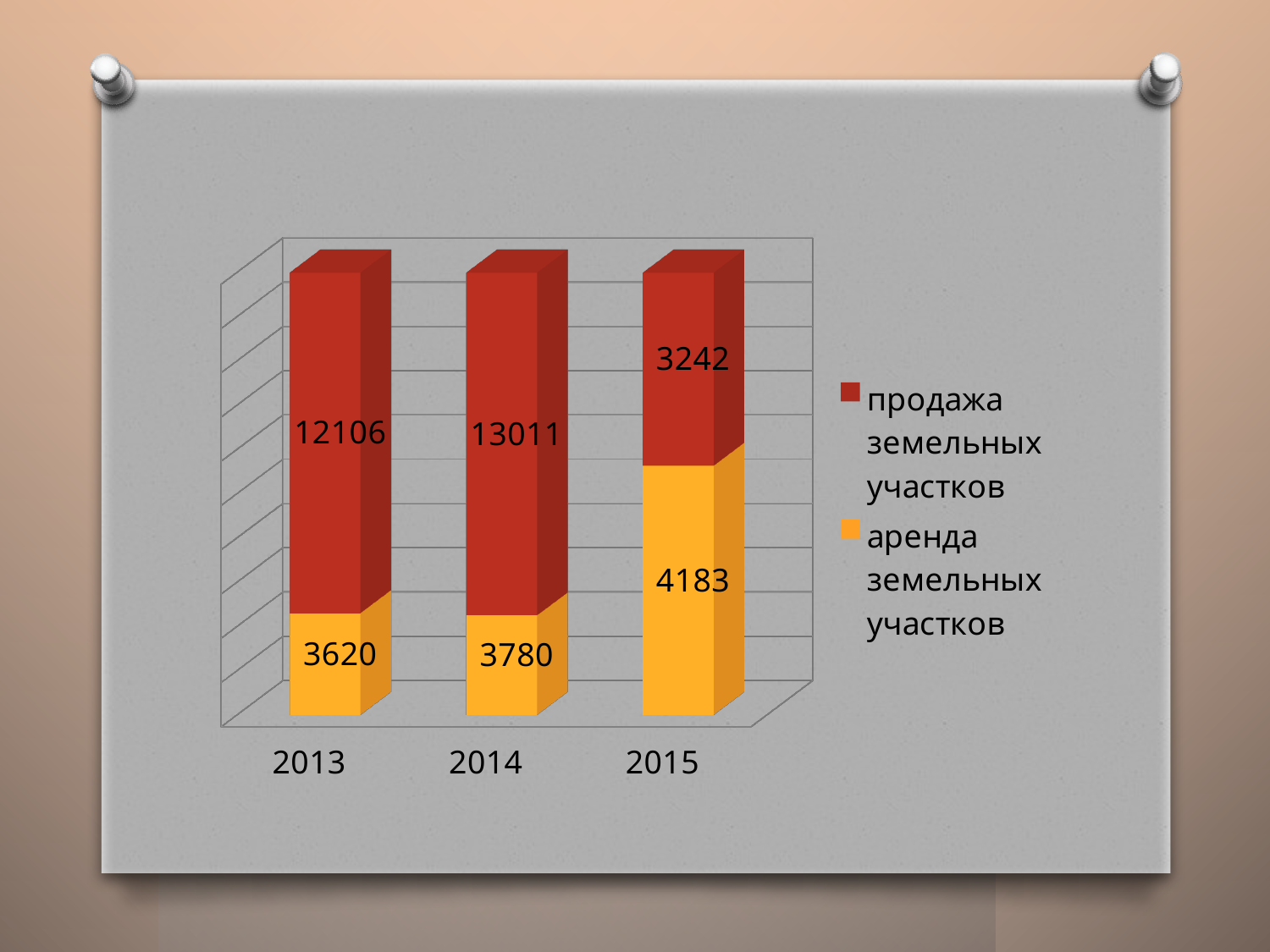
What is the difference between продажа земельных участков in 2014 and in 2013? 905 In which year is the value for продажа земельных участков highest? 2014 In which year is the value for аренда земельных участков lowest? 2013 Which is larger in 2015: продажа земельных участков or аренда земельных участков? аренда земельных участков Which colour represents аренда земельных участков in the legend? yellow How many years are shown on the x axis? 3 What is the value for продажа земельных участков in 2013? 12106 What is the value for аренда земельных участков in 2015? 4183 What kind of chart is shown on the slide? stacked bar chart What is the total of the stacked bar for 2015? 7425 What is the value for аренда земельных участков in 2014? 3780 How many series does the legend list? 2